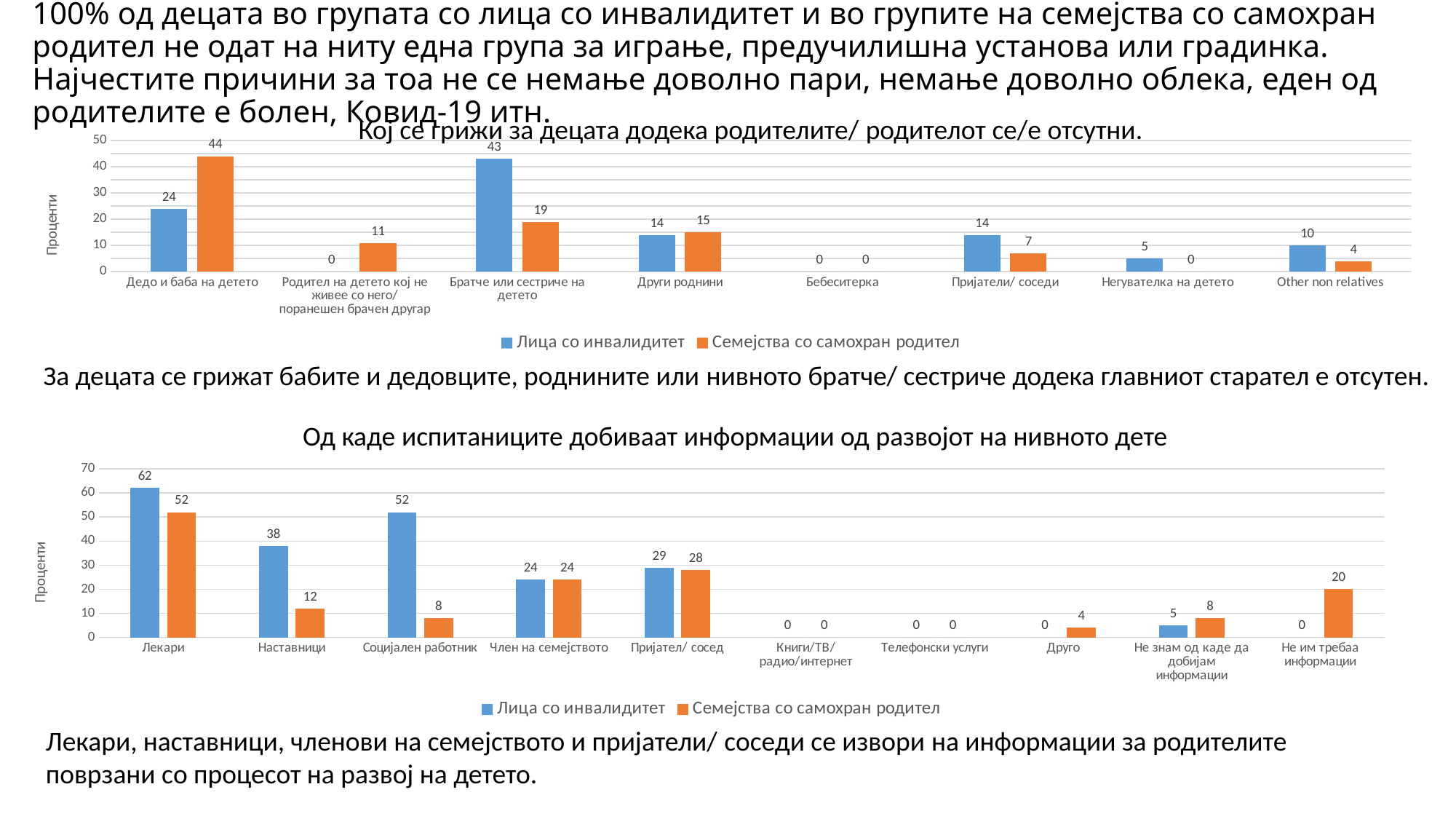
What type of chart is the bottom chart? Bar chart In the bottom chart, what is the value for Не им требаа информации in the Семејства со самохран родител series? 20 In the top chart, what is the value for Братче или сестриче на детето in the Лица со инвалидитет series? 43 In the top chart, how many categories are shown on the x axis? 8 In the top chart, which series has the larger value for Пријатели/ соседи? Лица со инвалидитет In the top chart, which category has the highest value in the Лица со инвалидитет series? Братче или сестриче на детето In the bottom chart (Од каде испитаниците добиваат информации од развојот на нивното дете), what is the value for Лекари in the Лица со инвалидитет series? 62 In the top chart, what is the difference between the two series for Дедо и баба на детето? 20 In the bottom chart, what is the difference between the two series for Социјален работник? 44 In the top chart (Кој се грижи за децата додека родителите/ родителот се/е отсутни), what is the value for Дедо и баба на детето in the Семејства со самохран родител series? 44 How many series does the legend of the bottom chart list? 2 In the bottom chart, how many categories are shown on the x axis? 10